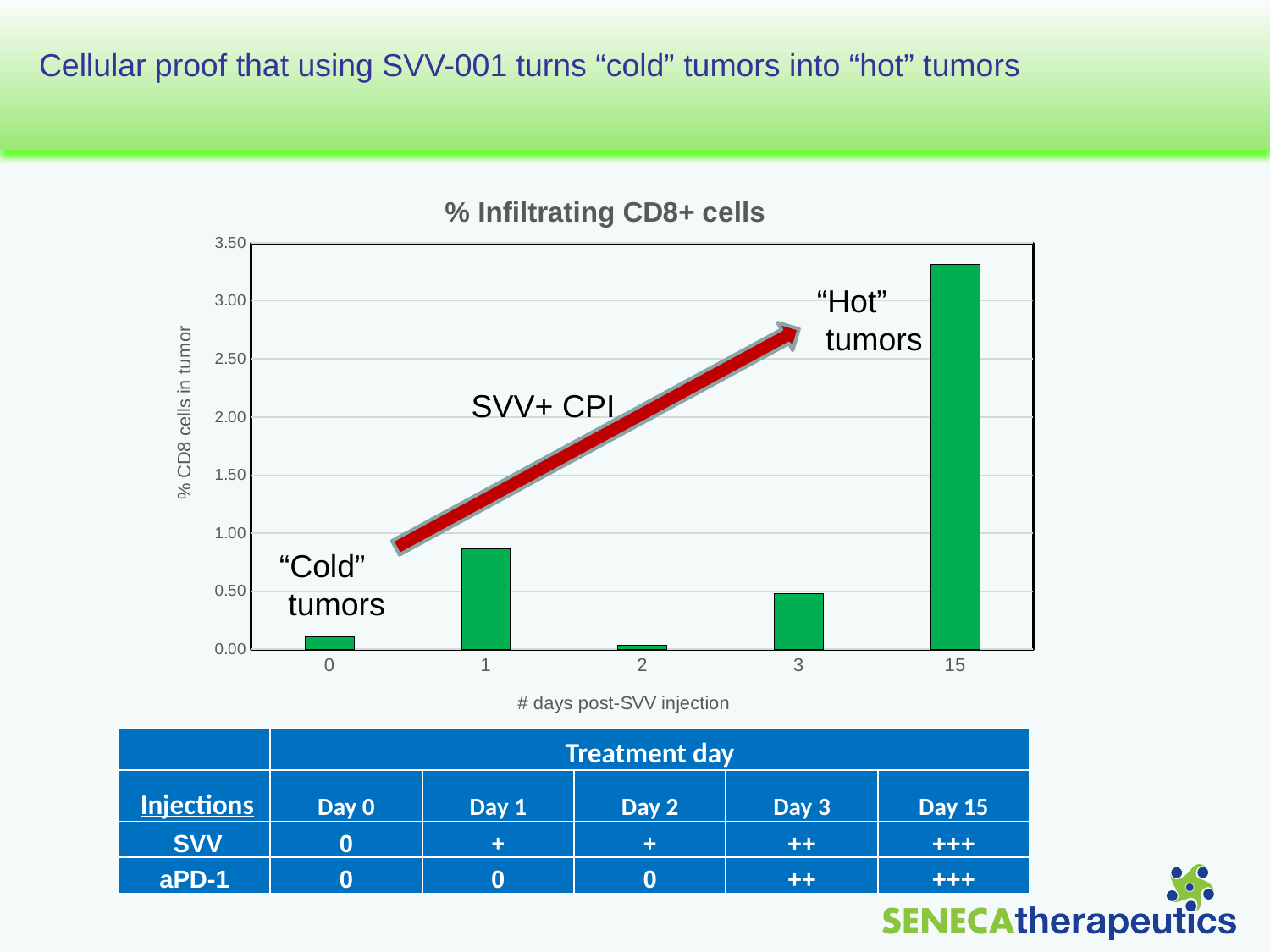
Is the value for day 1 greater or less than 1.00? less What is the label of the x axis? # days post-SVV injection Is the value for day 1 greater or less than 0.50? greater What is the title of the chart? % Infiltrating CD8+ cells What kind of chart is shown on the slide? bar chart Is the value for day 15 greater or less than 3.00? greater Which has a higher % CD8 cells in tumor, day 1 or day 3? day 1 Which day post-SVV injection has the highest % CD8 cells in tumor? 15 How many bars (time points) are plotted in the chart? 5 Which has a higher % CD8 cells in tumor, day 2 or day 15? day 15